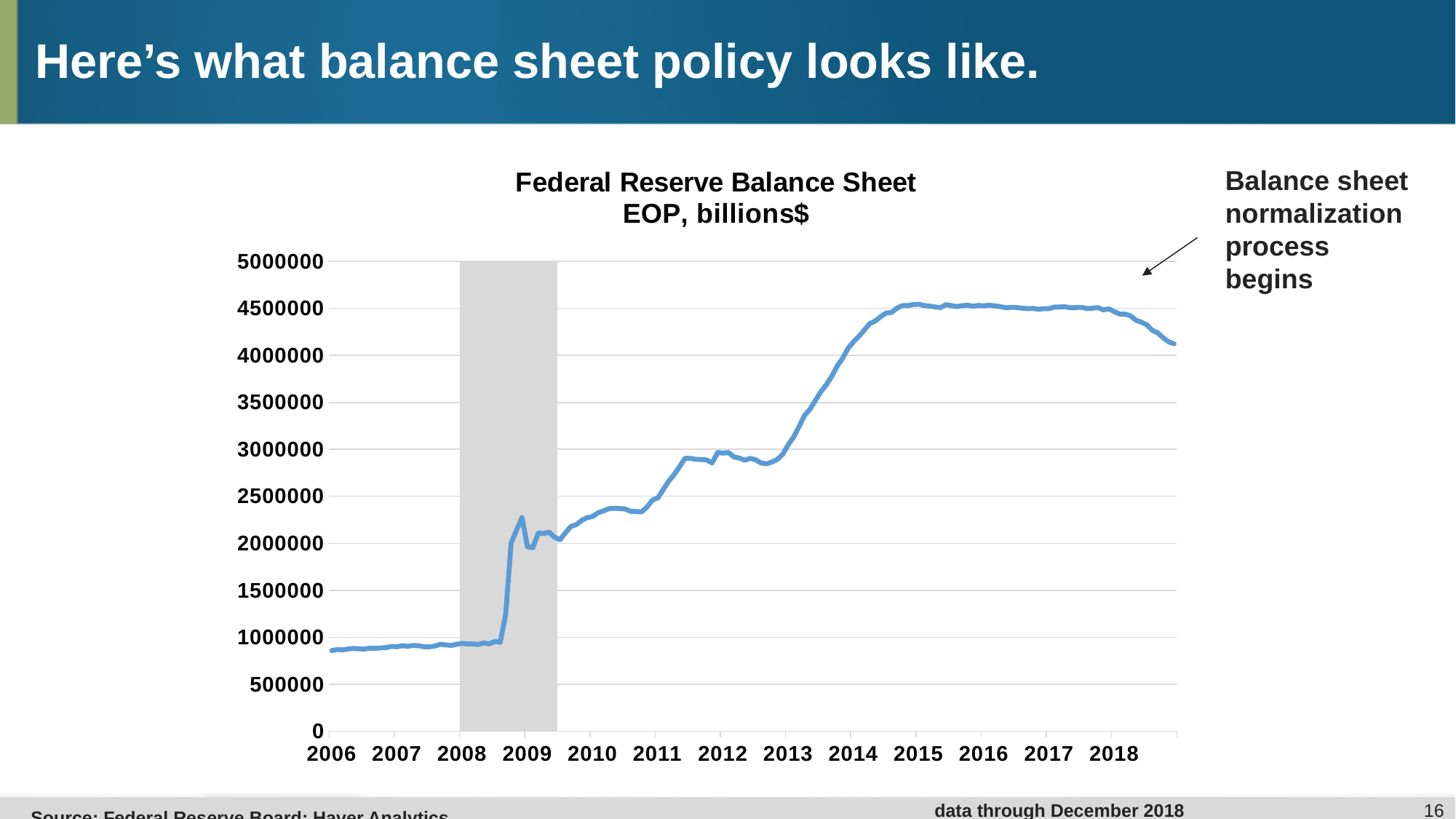
What is the title of the chart? Federal Reserve Balance Sheet EOP, billions$ Overall, does the Federal Reserve balance sheet rise or fall from 2006 to 2015? rise What kind of chart is shown on the slide? line chart Is the value of the balance sheet at the start of 2006 greater or less than 1000000? less Does the balance sheet line rise or fall between 2017 and the end of 2018? fall Is the value of the balance sheet in 2015 greater or less than 4000000? greater What does the annotation with the arrow on the right of the chart say? Balance sheet normalization process begins Is the balance sheet value higher in 2014 or in 2008? 2014 How many data series are plotted in the chart? 1 Is the value of the balance sheet at the start of 2012 greater or less than 2500000? greater How many year labels appear on the x axis of the chart? 13